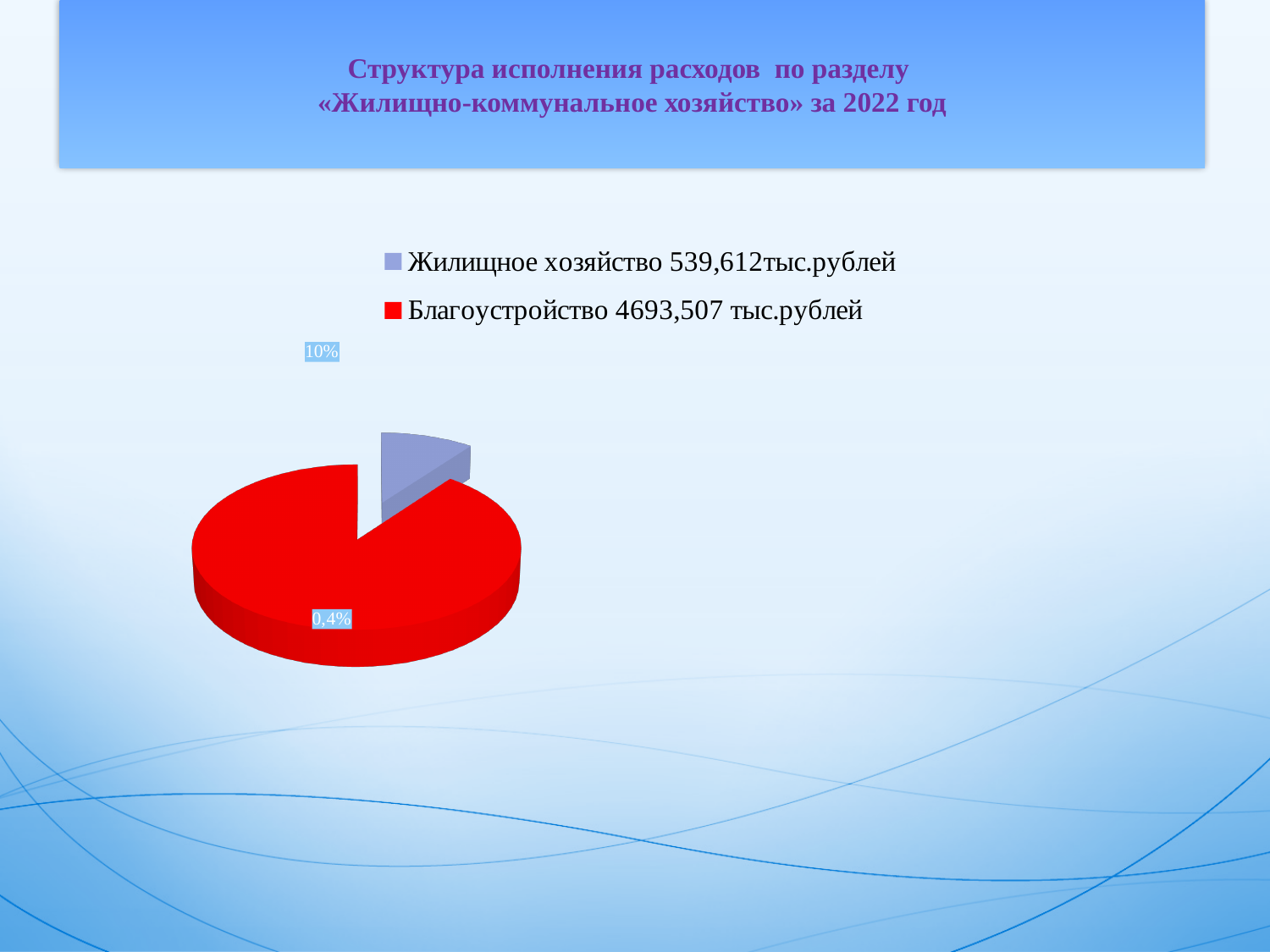
What kind of chart is shown on the slide? pie chart What is the difference between the values for Благоустройство and Жилищное хозяйство? 4153,895 тыс.рублей Which is larger, Жилищное хозяйство or Благоустройство? Благоустройство How many slices does the pie chart have? 2 What value does the legend give for Жилищное хозяйство? 539,612 тыс.рублей What value does the legend give for Благоустройство? 4693,507 тыс.рублей What colour is the Благоустройство slice? red How many entries does the legend list? 2 Which category has the smallest slice of the pie? Жилищное хозяйство What year does the slide title say the data is for? 2022 What percentage label is shown for the Жилищное хозяйство slice? 10% Which category has the largest slice of the pie? Благоустройство